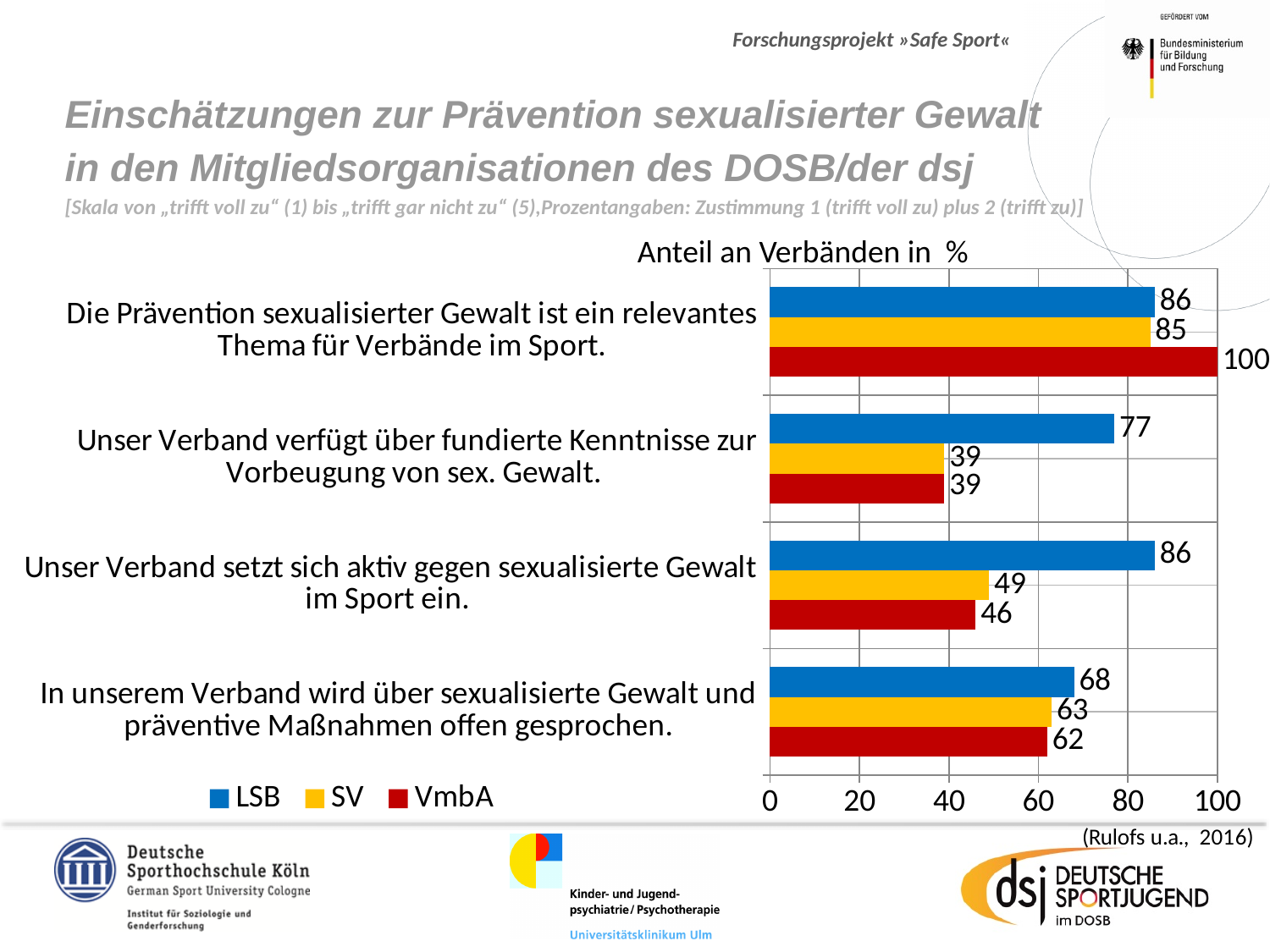
How many statements (categories) are shown in the chart? 4 What is the SV value for "Unser Verband setzt sich aktiv gegen sexualisierte Gewalt im Sport ein."? 49 How many series does the legend list? 3 Which is larger for "In unserem Verband wird über sexualisierte Gewalt und präventive Maßnahmen offen gesprochen.": the LSB value or the SV value? LSB Which series has the highest value for "Die Prävention sexualisierter Gewalt ist ein relevantes Thema für Verbände im Sport."? VmbA What is the axis title shown above the chart? Anteil an Verbänden in % What is the VmbA value for "Die Prävention sexualisierter Gewalt ist ein relevantes Thema für Verbände im Sport."? 100 Which series has the lowest value for "Unser Verband setzt sich aktiv gegen sexualisierte Gewalt im Sport ein."? VmbA What is the difference between the LSB and SV values for "Unser Verband verfügt über fundierte Kenntnisse zur Vorbeugung von sex. Gewalt."? 38 What is the VmbA value for "In unserem Verband wird über sexualisierte Gewalt und präventive Maßnahmen offen gesprochen."? 62 What kind of chart is shown on the slide? Bar chart What is the LSB value for "Unser Verband verfügt über fundierte Kenntnisse zur Vorbeugung von sex. Gewalt."? 77